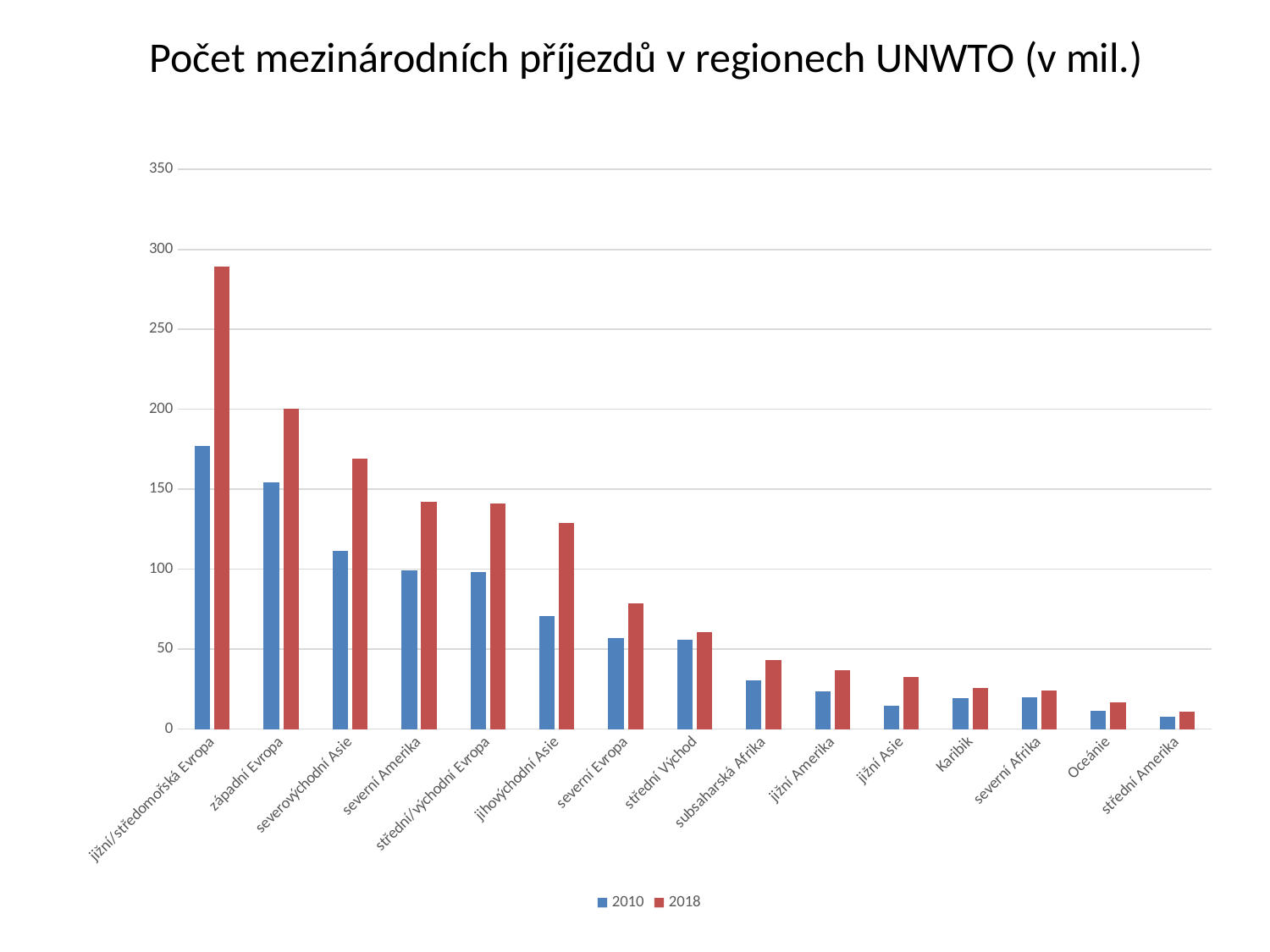
Which region has the highest value for 2018? jižní/středomořská Evropa Which is larger: the 2018 value for severovýchodní Asie or the 2018 value for severní Amerika? severovýchodní Asie Do the 2018 values generally rise or fall moving from left to right along the x axis? fall How many regions (categories) are shown on the x axis? 15 How many series does the legend list? 2 What kind of chart is shown on the slide? bar chart Is the 2010 value for severovýchodní Asie greater or less than 100? greater Is the 2018 value for subsaharská Afrika greater or less than 50? less Is the 2018 value for jižní/středomořská Evropa greater or less than 250? greater Which region has the lowest value for 2010? střední Amerika What is the title of the chart? Počet mezinárodních příjezdů v regionech UNWTO (v mil.)